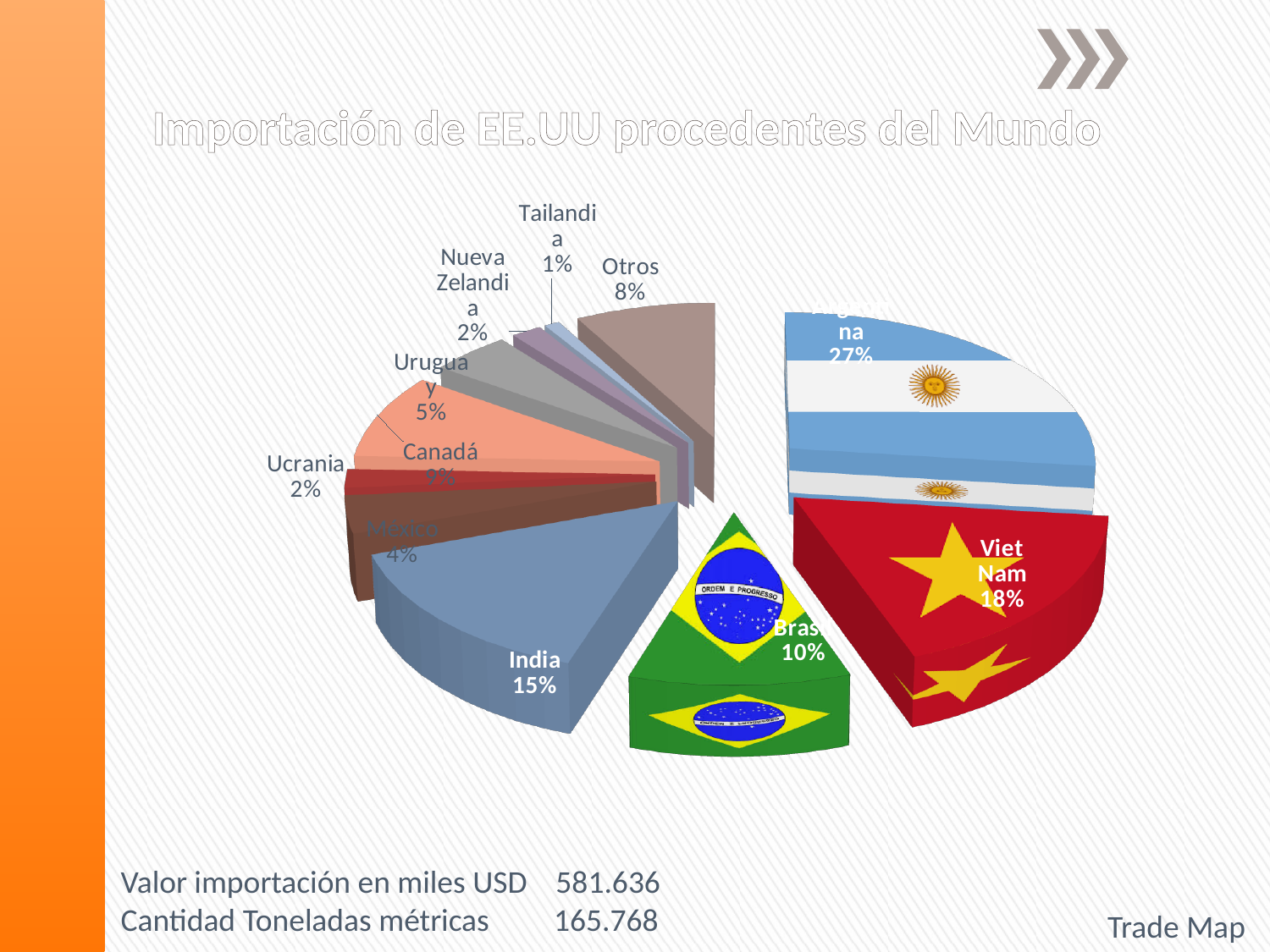
What percentage is shown for Otros? 8% What share of the pie does Viet Nam hold? 18% What is the difference in percentage points between Viet Nam and India? 3% What share of the pie does Brasil hold? 10% What share of the pie does India hold? 15% Which slice is the largest in the pie? Argentina What percentage is shown for México? 4% Which has a larger share, Brasil or Otros? Brasil What kind of chart is shown on the slide? pie chart Which country has the smallest slice of the pie? Tailandia What percentage is shown for Uruguay? 5% What is the title of the chart? Importación de EE.UU procedentes del Mundo